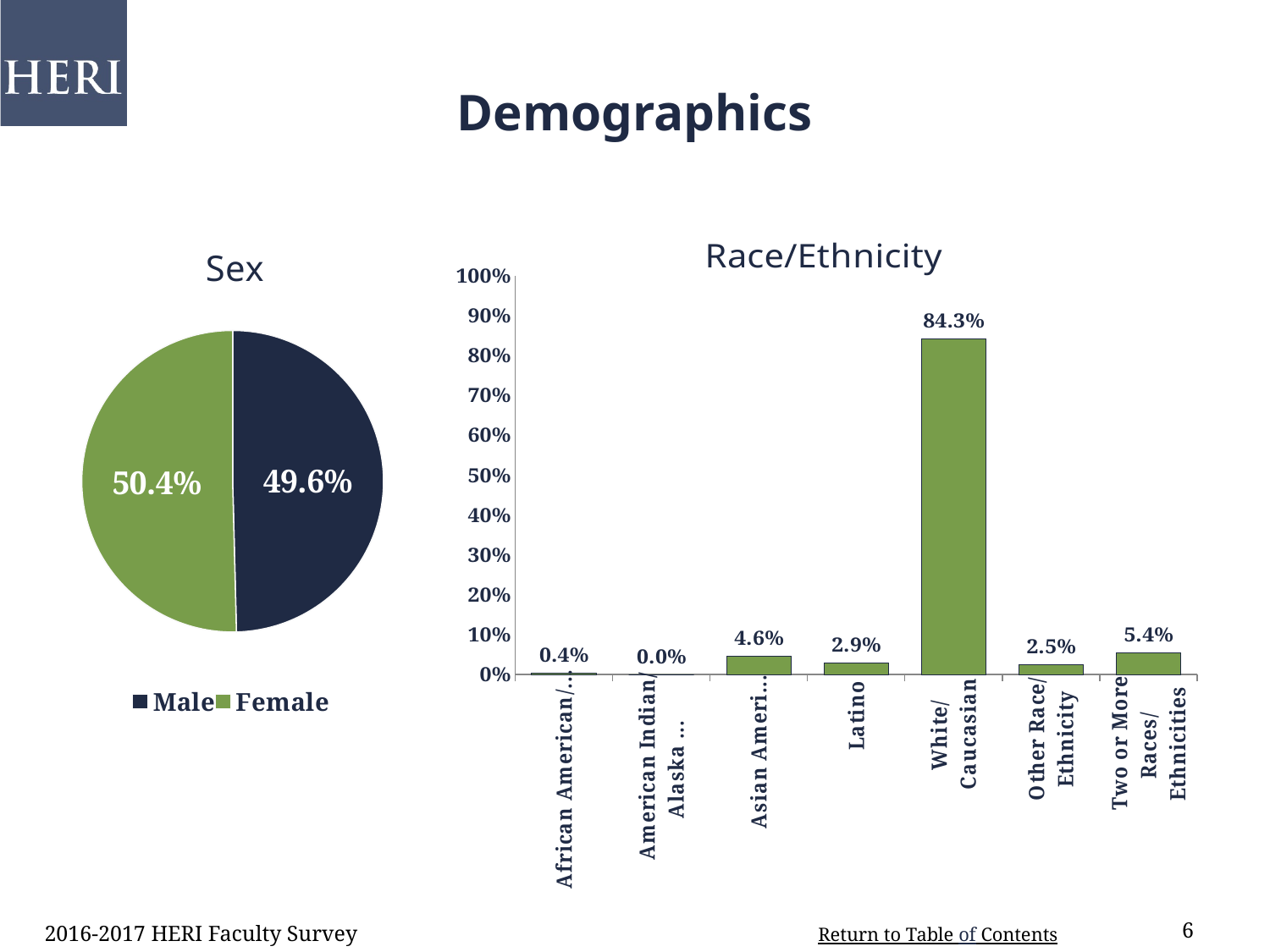
What kind of chart is the Sex chart? Pie chart In the Sex pie chart, which slice is larger, Male or Female? Female In the Sex pie chart, how many entries does the legend list? 2 In the Sex pie chart, what percentage is Female? 50.4% In the Race/Ethnicity chart, which category has the highest value? White/Caucasian In the Race/Ethnicity chart, what is the value for Two or More Races/Ethnicities? 5.4% In the Sex pie chart, what percentage is Male? 49.6% In the Race/Ethnicity chart, what is the difference between Two or More Races/Ethnicities and Other Race/Ethnicity? 2.9% What kind of chart is the Race/Ethnicity chart? Bar chart In the Race/Ethnicity chart, how many categories are shown on the x axis? 7 In the Race/Ethnicity chart, what is the value for White/Caucasian? 84.3% In the Race/Ethnicity chart, what is the value for Latino? 2.9%